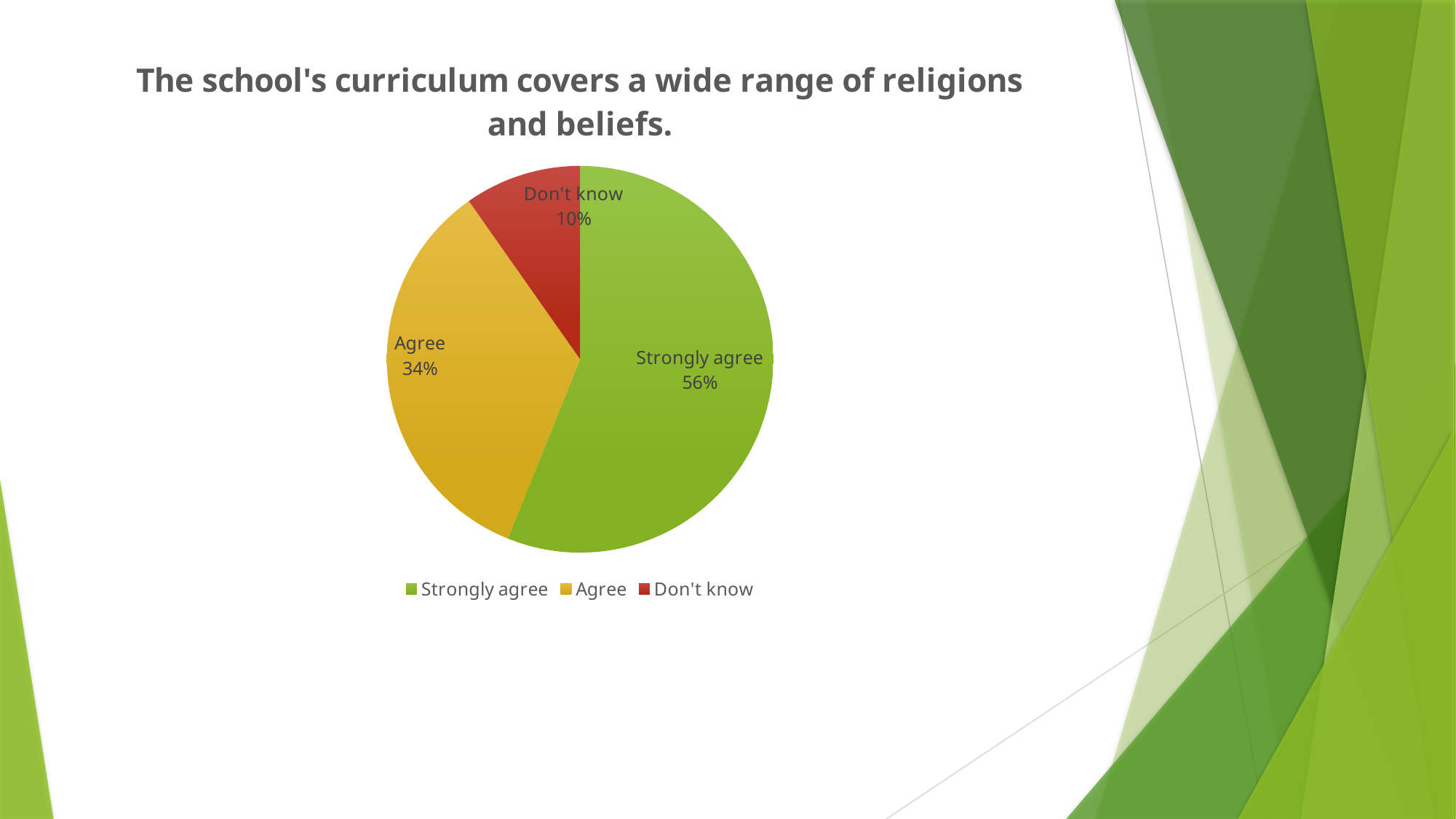
Which response has the smallest share of the pie? Don't know What is the title of the chart? The school's curriculum covers a wide range of religions and beliefs. What colour is the 'Don't know' slice? Red What kind of chart is shown on the slide? Pie chart Which response has the largest share of the pie? Strongly agree Which is larger, the share for 'Agree' or the share for 'Don't know'? Agree What percentage of respondents chose 'Agree'? 34% How many slices does the pie chart have? 3 What is the difference in percentage points between 'Agree' and 'Don't know'? 24 What percentage of respondents chose 'Strongly agree'? 56% What percentage of respondents chose 'Don't know'? 10% What is the difference in percentage points between 'Strongly agree' and 'Agree'? 22